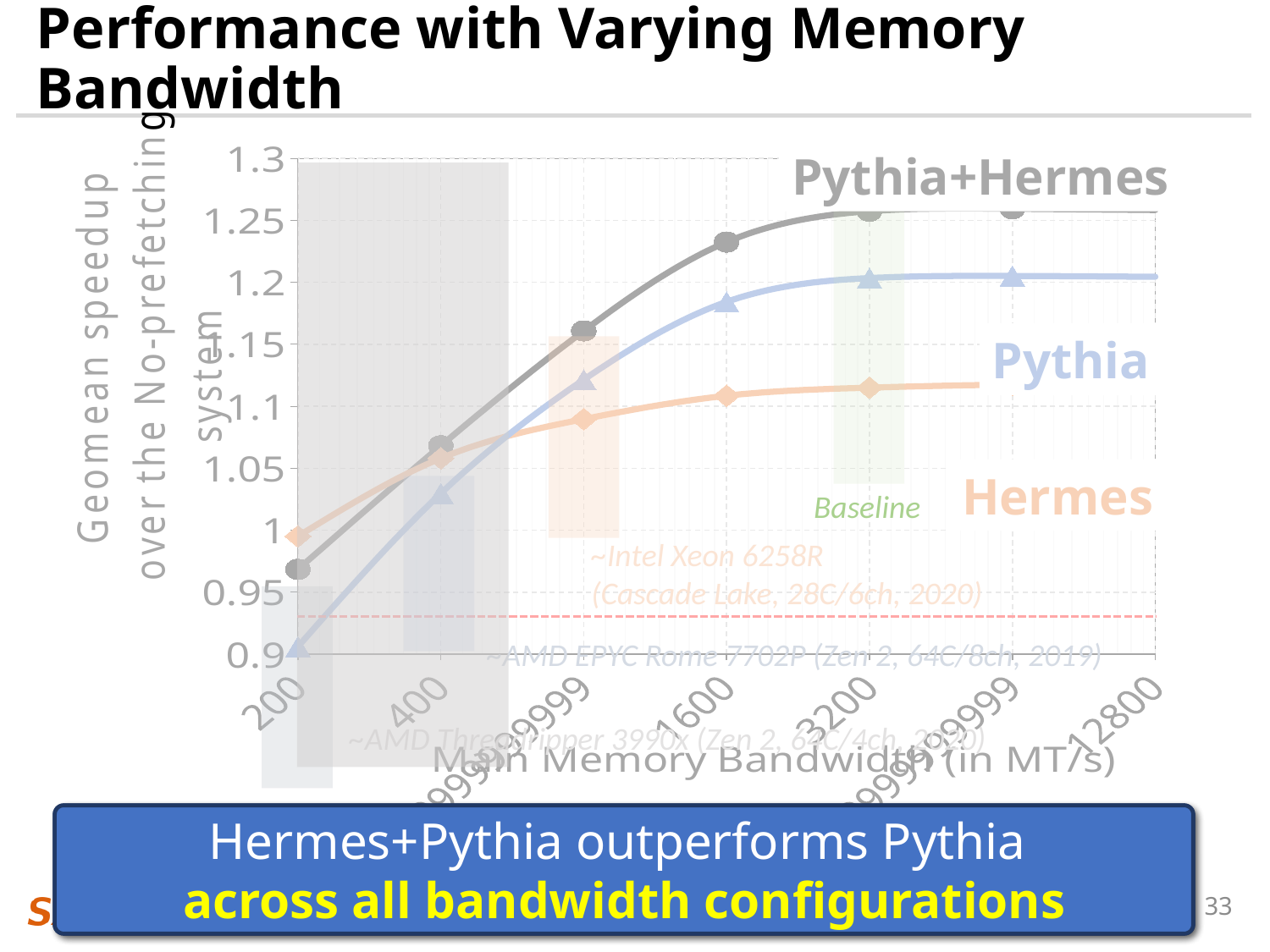
Is the value for Pythia+Hermes at 3200 MT/s greater or less than 1.2? greater Is the value for Hermes at 3200 MT/s greater or less than 1.15? less Which series has the lowest value at 200 MT/s? Pythia What is the title of the x axis of the chart? Main Memory Bandwidth (in MT/s) Is the value for Pythia+Hermes at 200 MT/s greater or less than 1? less Does the Pythia+Hermes series rise or fall as memory bandwidth increases along the x axis? rises What kind of chart is shown on the slide? line chart Which series has the highest value at 3200 MT/s? Pythia+Hermes At 1600 MT/s, which series has the larger value, Pythia+Hermes or Pythia? Pythia+Hermes At 200 MT/s, which series has the larger value, Hermes or Pythia? Hermes How many data series are plotted in the chart? 3